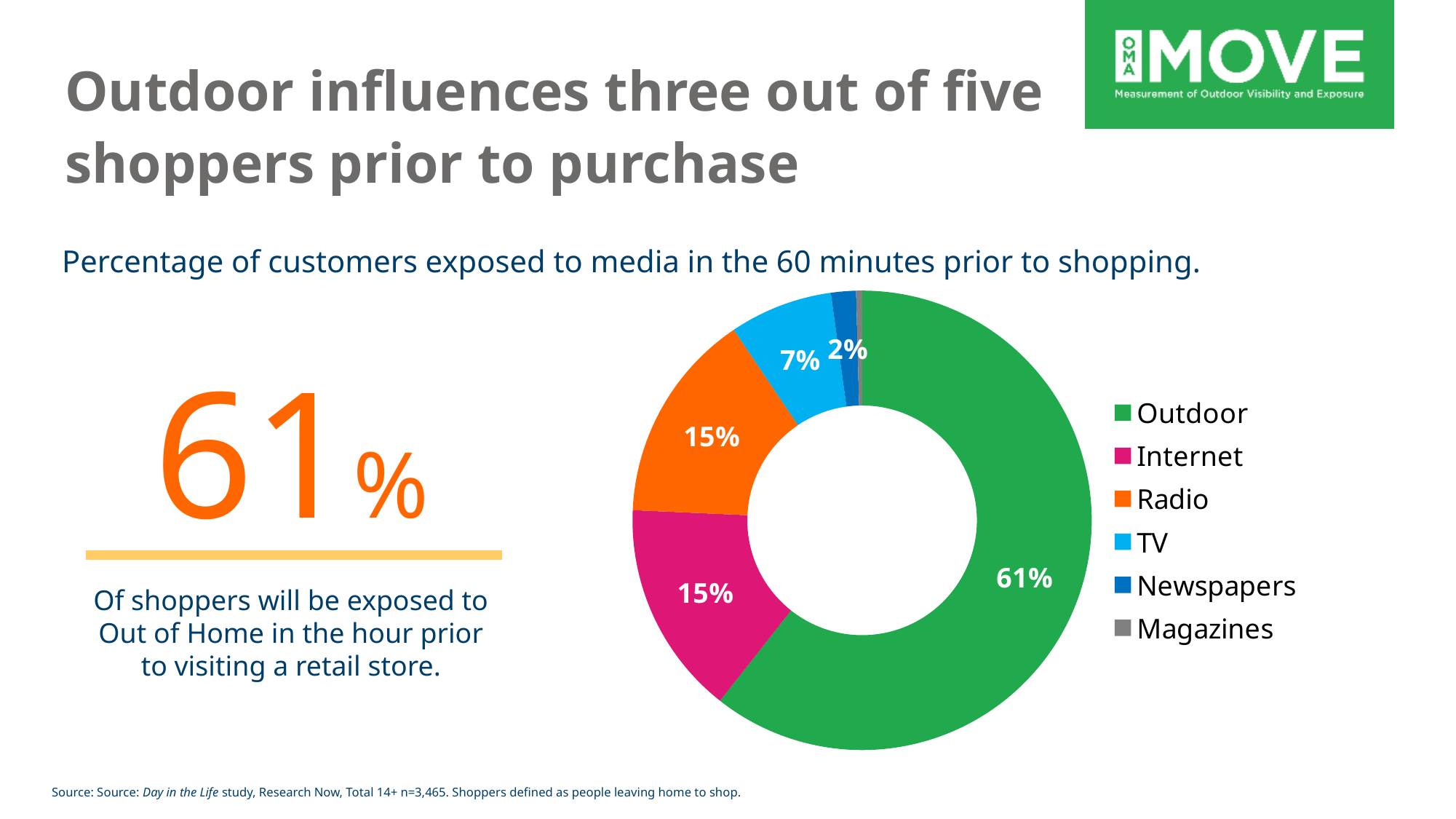
Which media category has the largest share in the donut chart? Outdoor How many media categories does the legend list? 6 Which has a larger share, Outdoor or Internet? Outdoor What type of chart is shown on the slide? Pie chart (donut) What percentage is shown for TV in the donut chart? 7% What is the difference in percentage points between TV and Newspapers? 5 What percentage is shown for Radio in the donut chart? 15% What percentage of customers were exposed to Outdoor media in the 60 minutes prior to shopping? 61% What is the difference in percentage points between Outdoor and Radio? 46 What percentage is shown for Newspapers in the donut chart? 2% Which media category has the smallest share in the donut chart? Magazines What colour represents Radio in the donut chart? Orange